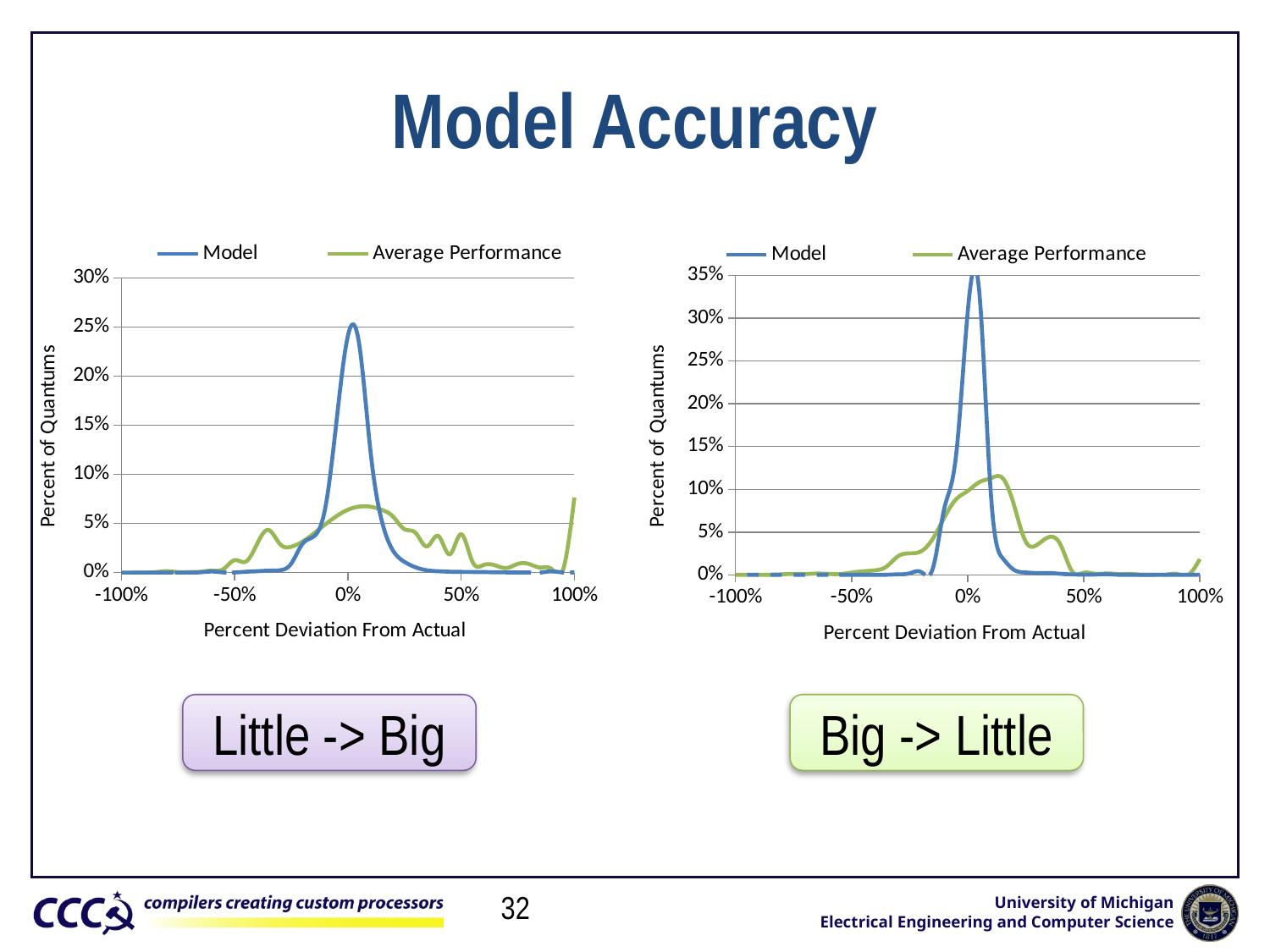
What kind of chart is the left chart (Little -> Big)? line chart In the right chart (Big -> Little), is the Average Performance value at 100% deviation greater or less than 5%? less In the right chart (Big -> Little), is the peak value of the Model series greater or less than 30%? greater What is the label of the y axis on the left chart (Little -> Big)? Percent of Quantums In the left chart (Little -> Big), which series reaches the higher peak, Model or Average Performance? Model What is the label of the x axis on the right chart (Big -> Little)? Percent Deviation From Actual In the left chart (Little -> Big), is the peak value of the Average Performance series greater or less than 10%? less How many series does the legend of the right chart (Big -> Little) list? 2 In the right chart (Big -> Little), which series reaches the higher peak, Model or Average Performance? Model